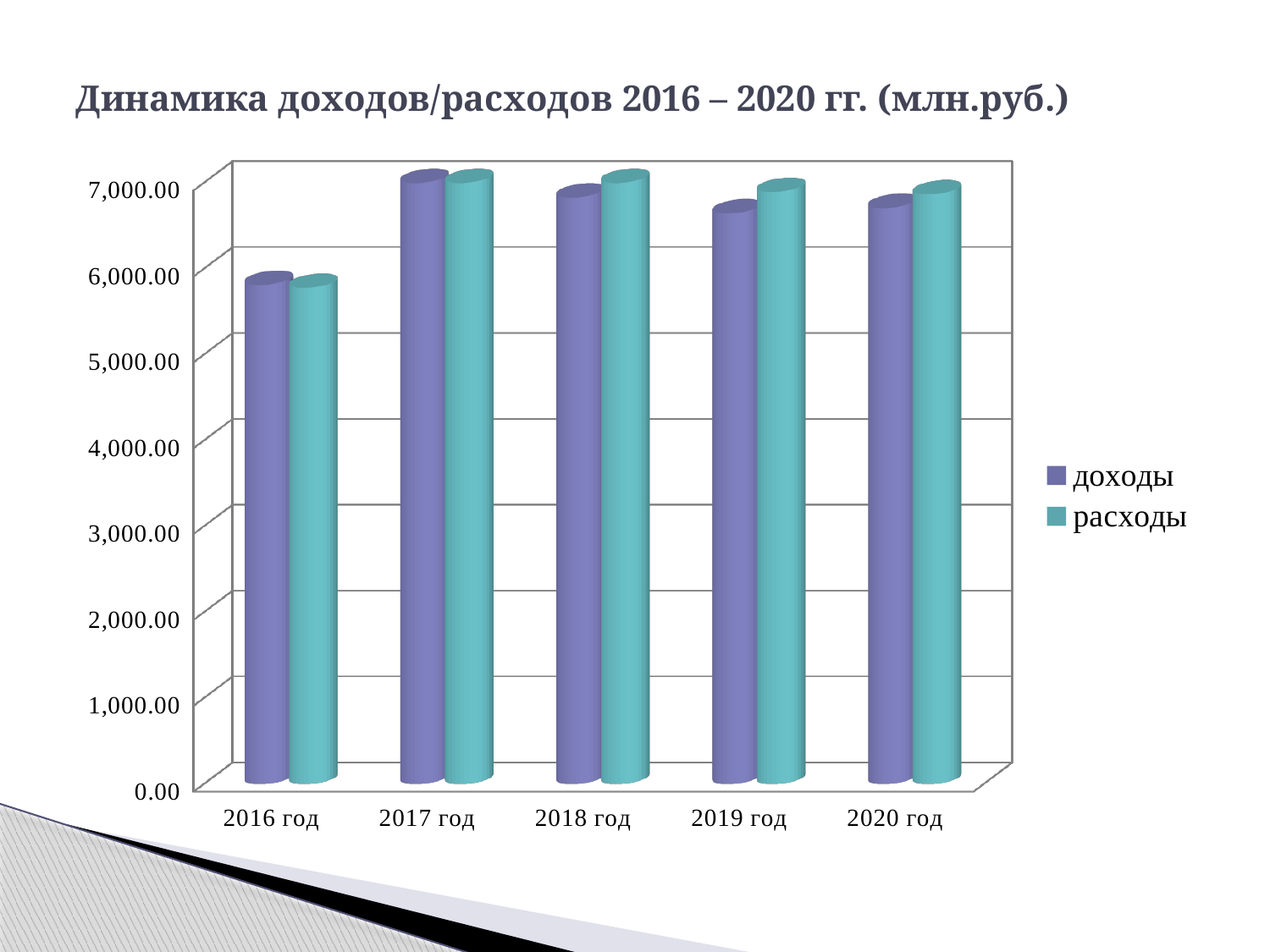
How many series does the legend list? 2 Which series are listed in the legend? доходы, расходы Which is larger in 2019 год, доходы or расходы? расходы What kind of chart is shown on the slide? bar chart What is the title of the chart? Динамика доходов/расходов 2016 – 2020 гг. (млн.руб.) Which year has the highest value for доходы? 2017 год Is the value for доходы in 2016 год greater or less than 6,000.00? less Which year has the lowest value for расходы? 2016 год Which year has the lowest value for доходы? 2016 год Do the values for доходы rise or fall from 2017 год to 2019 год? fall How many years are shown on the x axis? 5 Is the value for доходы in 2019 год greater or less than 6,000.00? greater